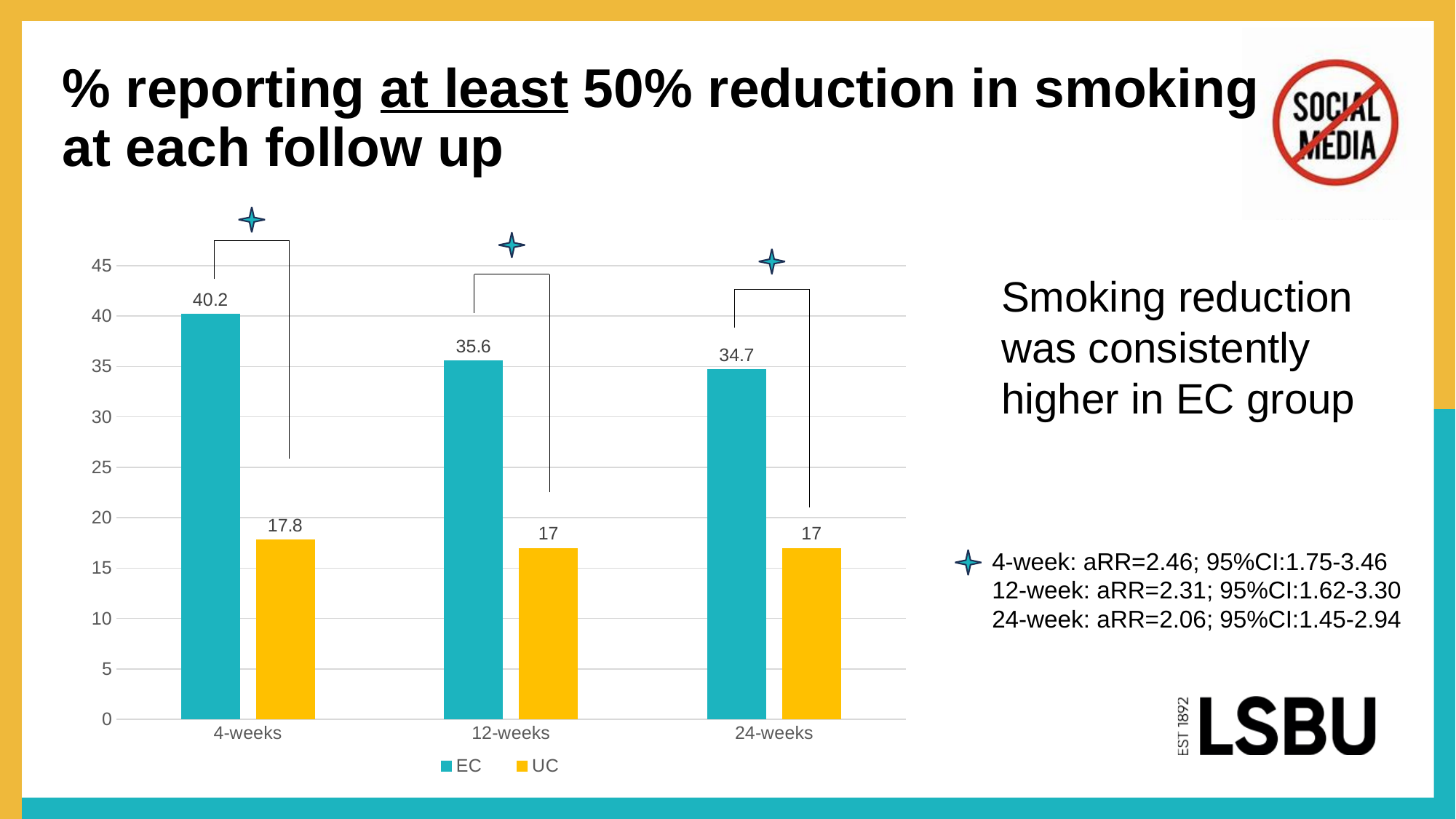
What is the value for UC at 4-weeks? 17.8 At which follow-up is the EC value highest? 4-weeks Which is larger at 24-weeks, EC or UC? EC How many series does the legend list? 2 What is the value for EC at 4-weeks? 40.2 What is the difference between the EC and UC values at 4-weeks? 22.4 What is the difference between the EC values at 12-weeks and 24-weeks? 0.9 How many follow-up categories are shown on the x axis? 3 What kind of chart is shown on the slide? Bar chart What is the value for EC at 24-weeks? 34.7 What is the value for UC at 12-weeks? 17 At which follow-up is the EC value lowest? 24-weeks